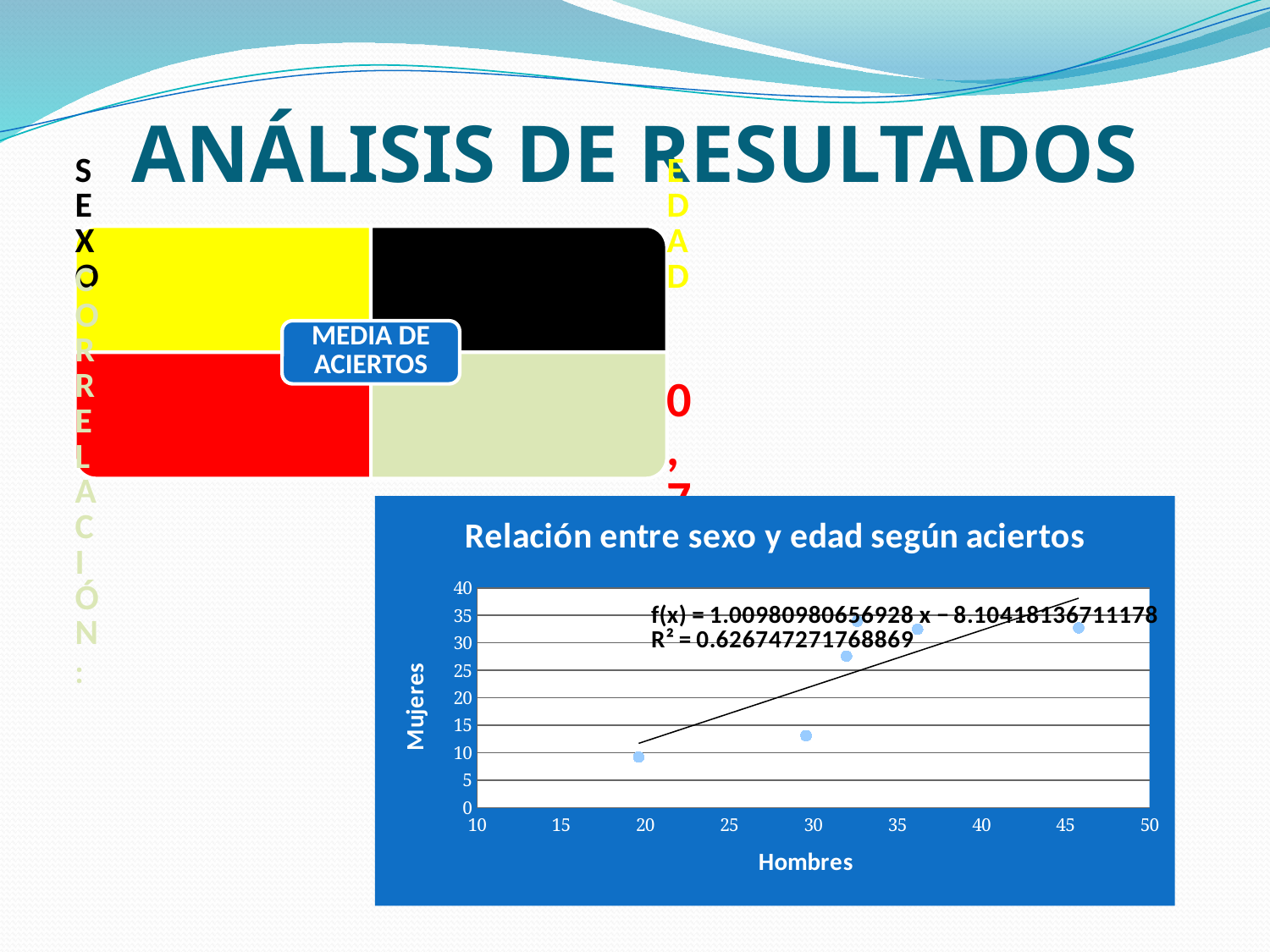
Do the plotted values generally rise or fall as Hombres increases along the x axis? rise What kind of chart is shown on the slide? scatter chart Is the highest Mujeres value plotted in the chart greater or less than 30? greater What is the title of the chart on the slide? Relación entre sexo y edad según aciertos Is the Mujeres value of the point near Hombres = 30 greater or less than 20? less Which has the larger Mujeres value: the point with the smallest Hombres value or the point with the largest Hombres value? the point with the largest Hombres value What trendline equation is printed on the chart? f(x) = 1.00980980656928 x − 8.10418136711178 Is the Mujeres value of the point with the largest Hombres value greater or less than 30? greater What R² value is printed on the chart? R² = 0.626747271768869 What is the label of the x axis of the chart? Hombres How many data points are plotted in the chart? 6